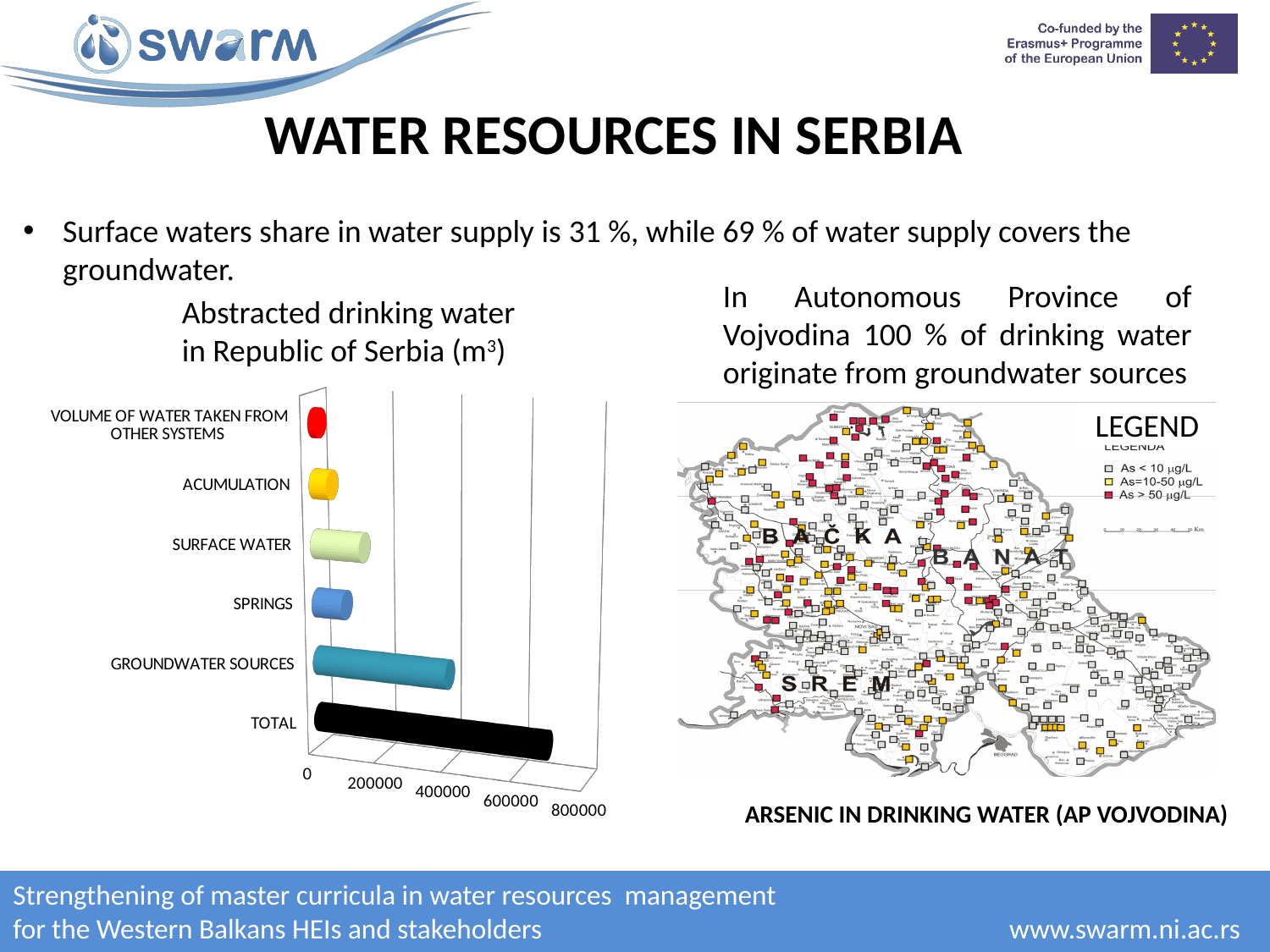
In the abstracted drinking water chart, is the value for TOTAL greater or less than 400000? greater What type of chart is used to show abstracted drinking water in Republic of Serbia? bar chart How many categories are shown in the abstracted drinking water bar chart? 6 What is the title of the bar chart on the slide? Abstracted drinking water in Republic of Serbia (m3) In the abstracted drinking water chart, which is larger: SURFACE WATER or SPRINGS? SURFACE WATER In the abstracted drinking water chart, is the value for GROUNDWATER SOURCES greater or less than 200000? greater Which category has the shortest bar in the abstracted drinking water chart? VOLUME OF WATER TAKEN FROM OTHER SYSTEMS Which category has the longest bar in the abstracted drinking water chart? TOTAL In the abstracted drinking water chart, is the value for SPRINGS greater or less than 200000? less In the abstracted drinking water chart, which is larger: GROUNDWATER SOURCES or SURFACE WATER? GROUNDWATER SOURCES What is the highest tick value shown on the value axis of the abstracted drinking water chart? 800000